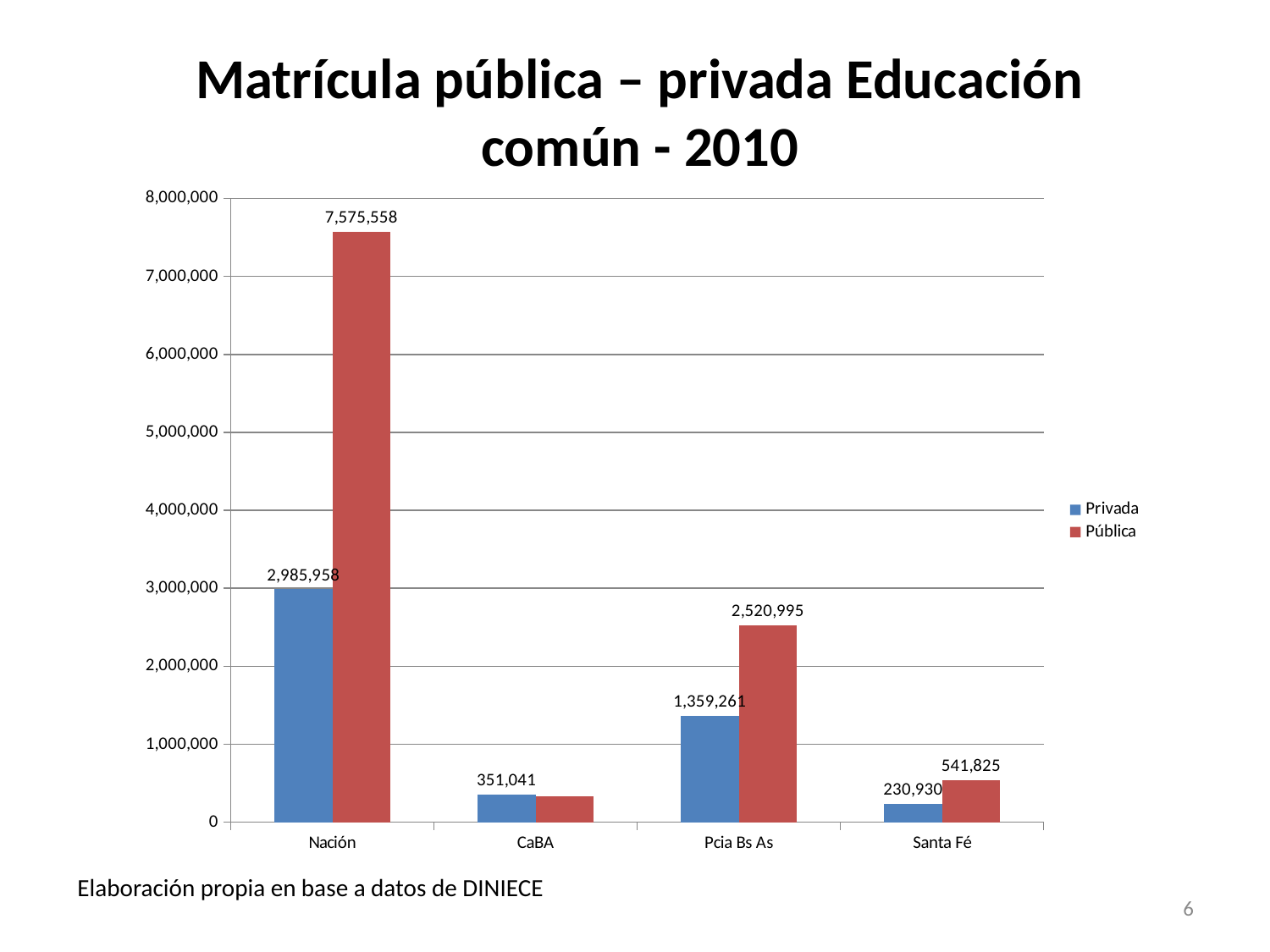
What kind of chart is shown on the slide? bar chart How many series does the legend list? 2 Which category has the lowest Privada value? Santa Fé Which category has the highest Pública value? Nación Is the Pública value for CaBA greater or less than 1,000,000? less What is the difference between the Pública and Privada values for Nación? 4,589,600 What is the value of the Pública bar for Santa Fé? 541,825 For Pcia Bs As, which is larger: Privada or Pública? Pública How many categories are shown on the x axis? 4 What is the value of the Privada bar for Pcia Bs As? 1,359,261 What is the value of the Pública bar for Nación? 7,575,558 What is the difference between the Pública and Privada values for Santa Fé? 310,895